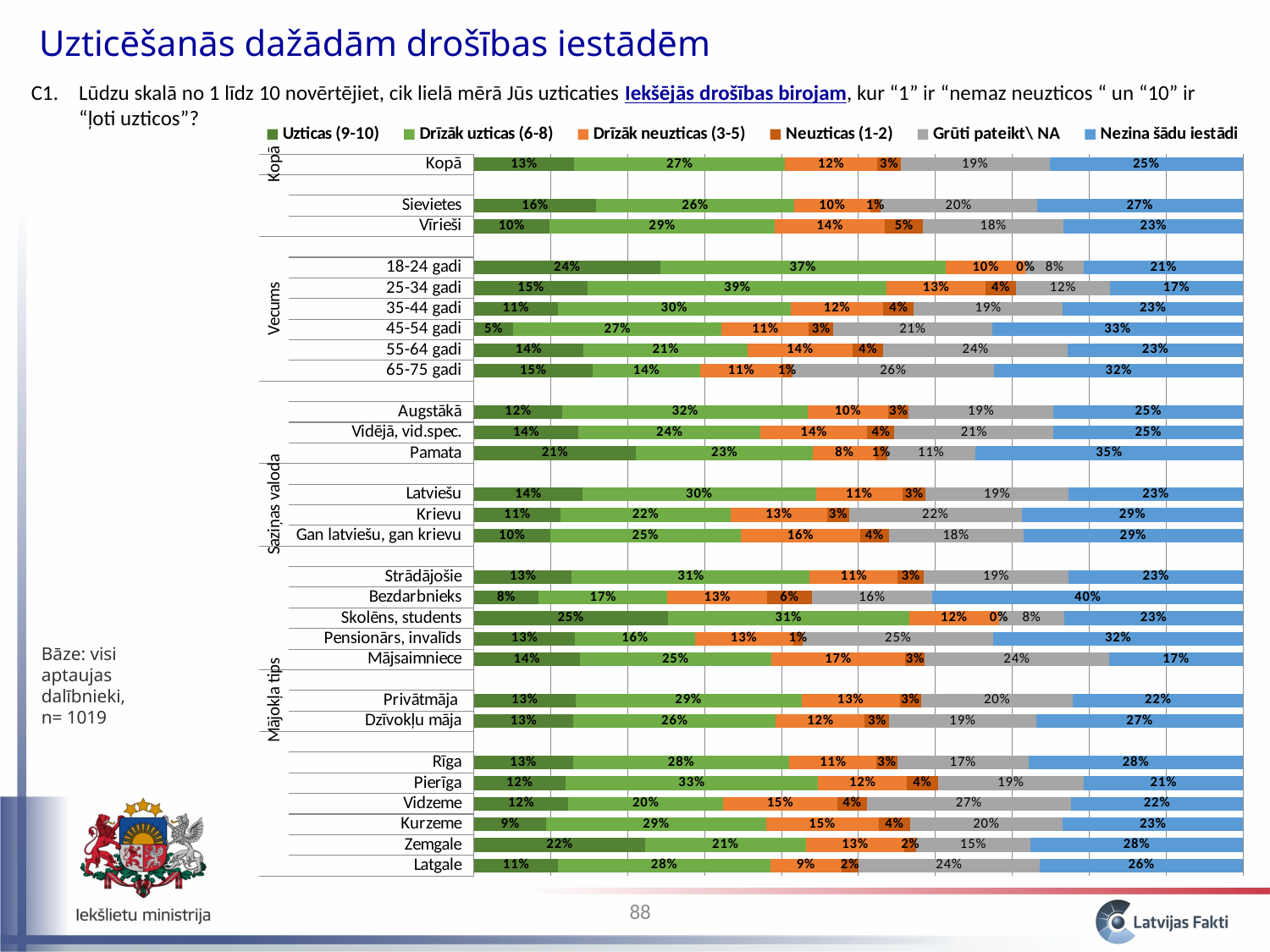
What is the value of 'Grūti pateikt\ NA' for 'Vidzeme'? 27% What is the value of 'Nezina šādu iestādi' for 'Bezdarbnieks'? 40% Which category has the lowest 'Uzticas (9-10)' value? 45-54 gadi What is the value of 'Drīzāk uzticas (6-8)' for '25-34 gadi'? 39% What is the difference between the 'Nezina šādu iestādi' values for 'Sievietes' and 'Vīrieši'? 4% Which has a larger 'Uzticas (9-10)' value: 'Zemgale' or 'Latgale'? Zemgale Which legend entry is shown in blue? Nezina šādu iestādi What is the value of 'Uzticas (9-10)' for the 'Kopā' row? 13% Which category has the highest 'Nezina šādu iestādi' value? Bezdarbnieks How many categories (rows) are plotted in the chart? 28 How many series does the legend list? 6 What type of chart is shown on the slide? Stacked bar chart